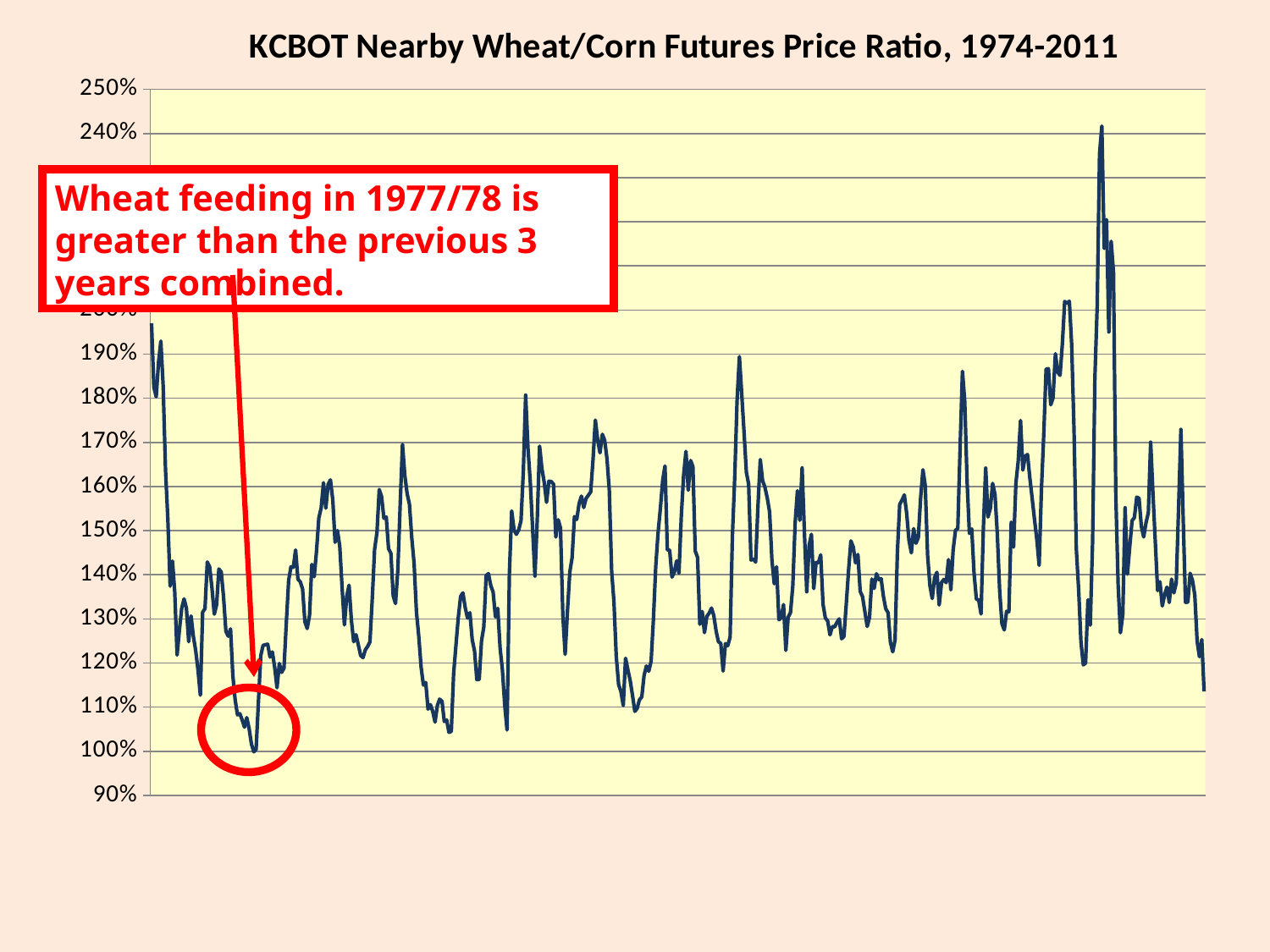
Is the value at the right end of the line higher or lower than the value at the left end? lower Is the highest peak of the line greater or less than 230%? greater What is the highest value shown on the vertical axis? 250% How many data series are plotted on the chart? 1 What kind of chart is shown on the slide? Line chart Is the value at the start of the series (left end of the line) greater or less than 180%? greater What value does the circled low point of the line reach? 100% Is the lowest point of the line (the circled point) greater or less than 110%? less What is the title of the chart? KCBOT Nearby Wheat/Corn Futures Price Ratio, 1974-2011 According to the annotation on the chart, wheat feeding in which season is greater than the previous 3 years combined? 1977/78